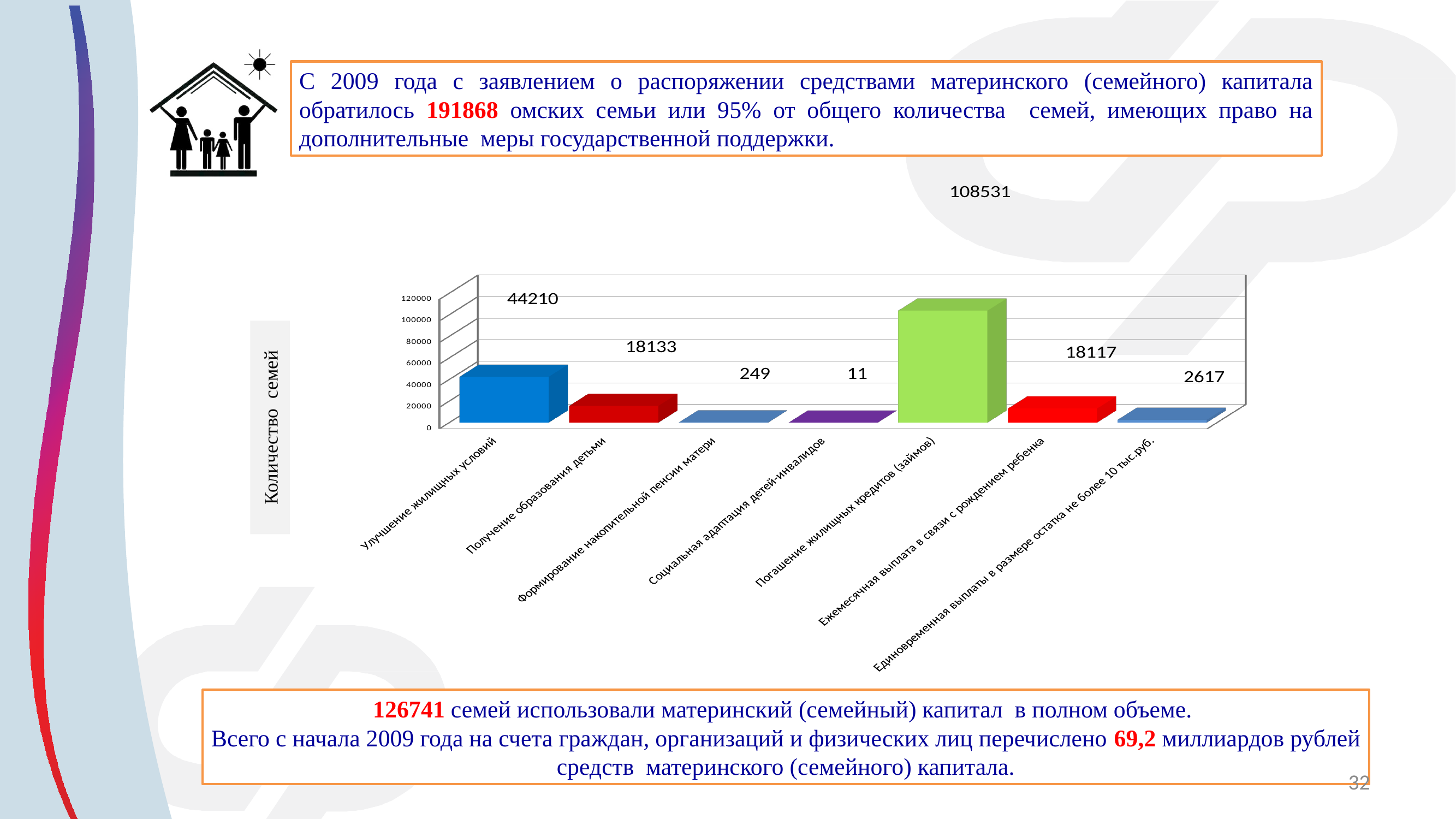
What is the value for "Улучшение жилищных условий"? 44210 How many categories are plotted in the chart? 7 What is the value for "Погашение жилищных кредитов (займов)"? 108531 Which category has the highest value? Погашение жилищных кредитов (займов) Which is larger: the value for "Улучшение жилищных условий" or the value for "Получение образования детьми"? Улучшение жилищных условий Which category has the lowest value? Социальная адаптация детей-инвалидов What is the label on the vertical axis of the chart? Количество семей What is the difference between the values for "Погашение жилищных кредитов (займов)" and "Улучшение жилищных условий"? 64321 What is the value for "Социальная адаптация детей-инвалидов"? 11 What is the difference between the values for "Получение образования детьми" and "Ежемесячная выплата в связи с рождением ребенка"? 16 What type of chart is shown on the slide? bar chart What is the value for "Единовременная выплаты в размере остатка не более 10 тыс.руб."? 2617